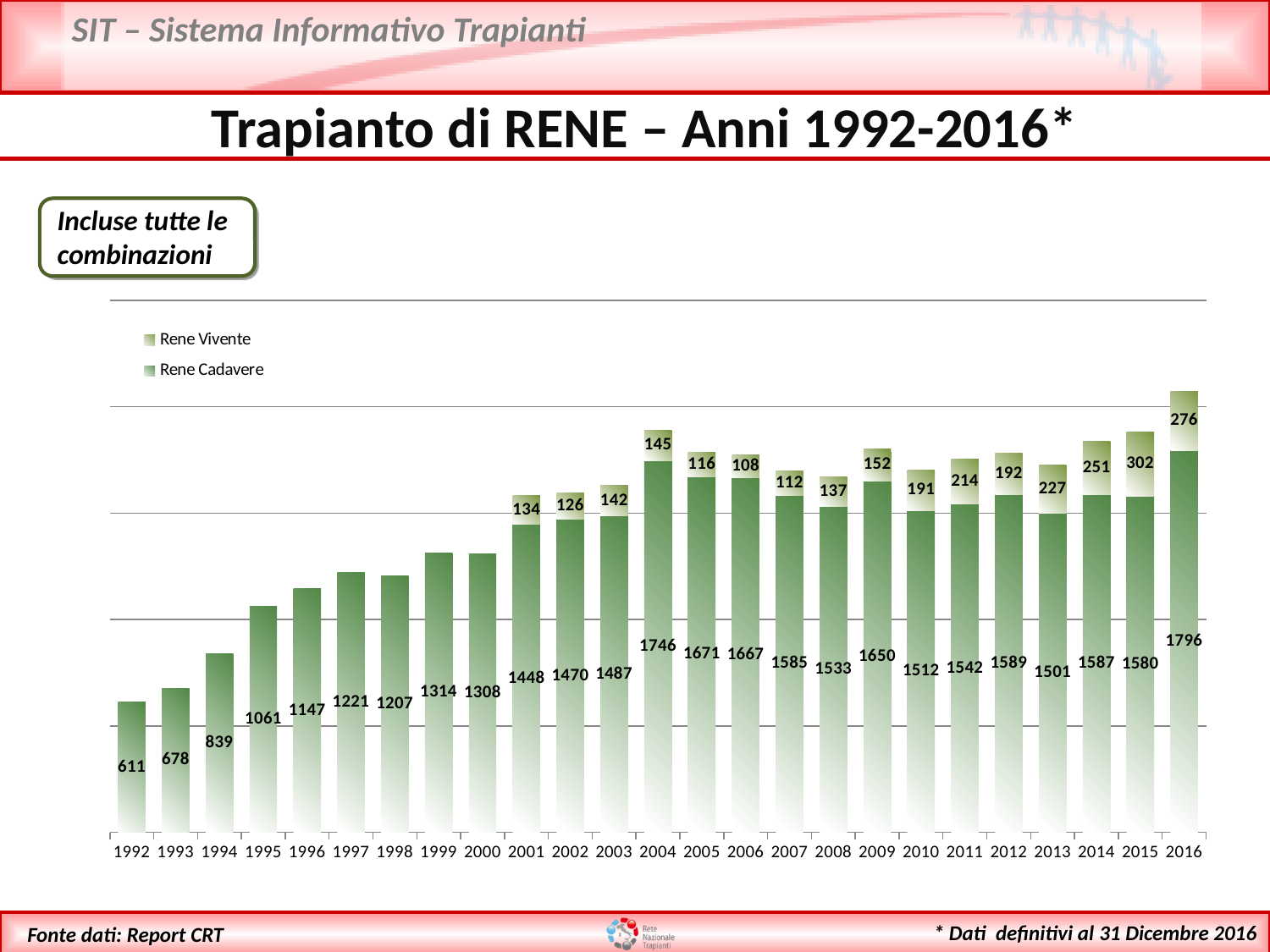
What is the Rene Cadavere value for 2004? 1746 What is the total of the stacked bar for 2016? 2072 What kind of chart is shown on the slide? Stacked bar chart How many series does the legend list? 2 Which is larger, the Rene Cadavere value for 2005 or for 2006? 2005 How many years are shown on the x axis? 25 Which year has the highest Rene Vivente value? 2015 Which year has the highest Rene Cadavere value? 2016 Which year has the lowest Rene Vivente value among the labelled years? 2006 What is the Rene Vivente value for 2013? 227 What is the difference between the Rene Cadavere values for 2016 and 1992? 1185 What is the Rene Cadavere value for 1995? 1061